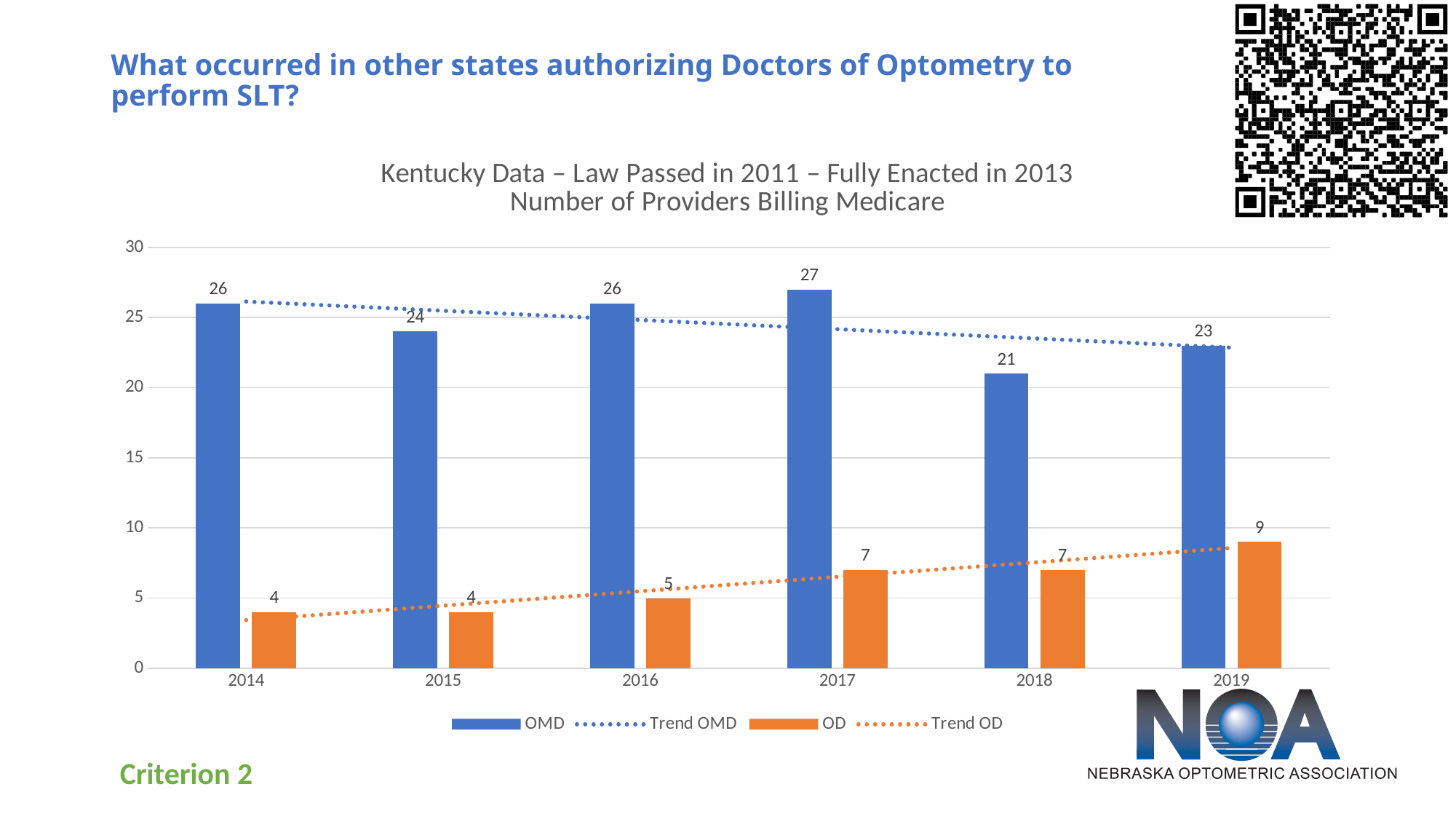
What kind of chart is shown on the slide? Bar chart with trend lines How many entries does the legend list? 4 How many years are shown on the x axis? 6 In which year is the OD value highest? 2019 Which is larger, the OD value in 2016 or the OD value in 2018? 2018 Does the OD trend line rise or fall from 2014 to 2019? Rise What is the OMD value for 2018? 21 What is the difference between the OMD and OD values in 2014? 22 What is the OMD value for 2017? 27 In which year is the OMD value lowest? 2018 In which year is the OMD value highest? 2017 What is the OD value for 2019? 9